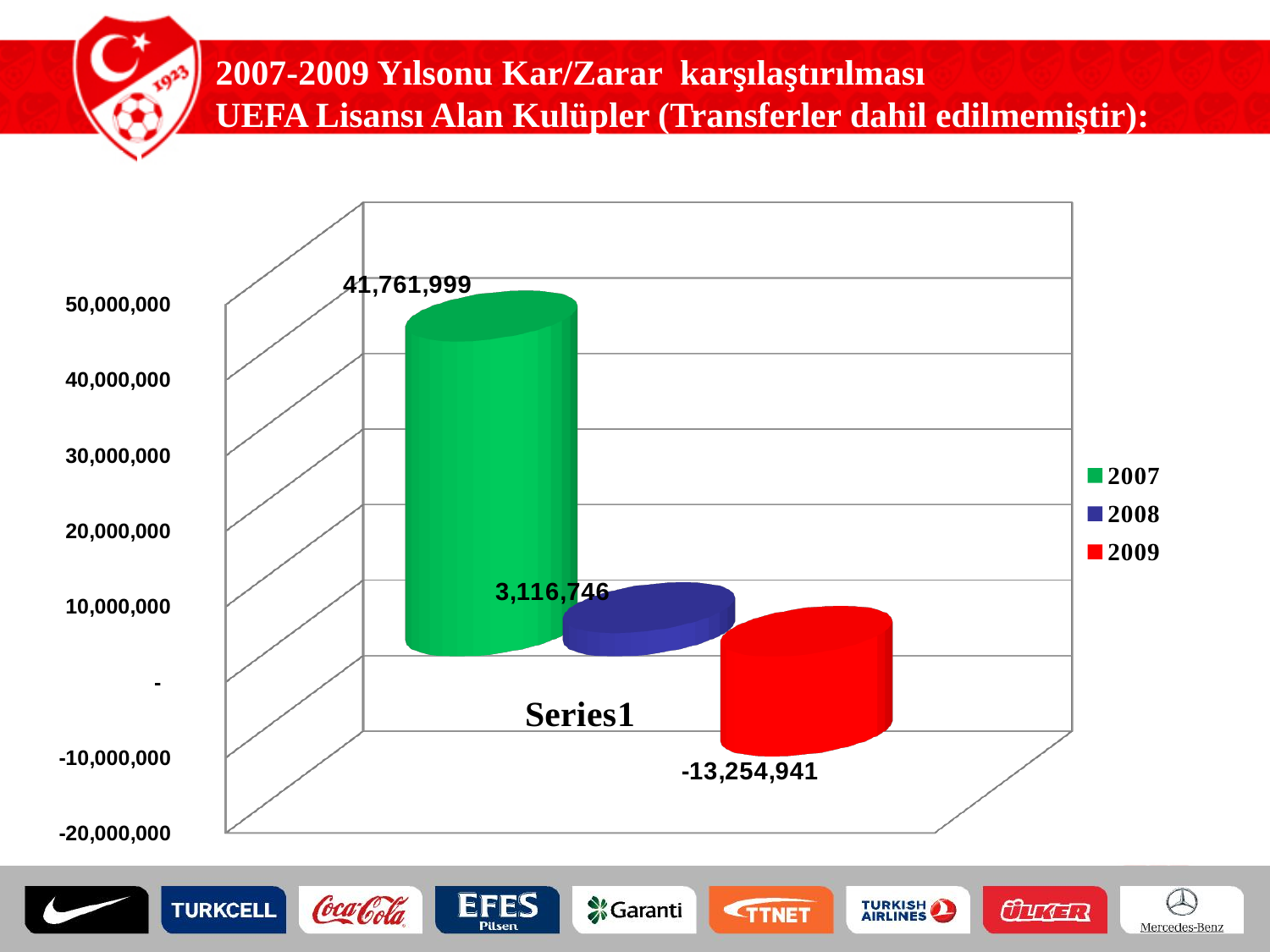
Which is larger, the value for 2008 or the value for 2009? 2008 Is the value for 2007 greater or less than 40,000,000? greater What is the value for 2009? -13,254,941 What kind of chart is shown on the slide? bar chart What is the difference between the values for 2008 and 2009? 16,371,687 How many series does the legend list? 3 Which year has the highest value? 2007 What is the difference between the values for 2007 and 2008? 38,645,253 What is the value for 2007? 41,761,999 Do the values rise or fall from 2007 to 2009? fall What is the value for 2008? 3,116,746 Which year has the lowest value? 2009